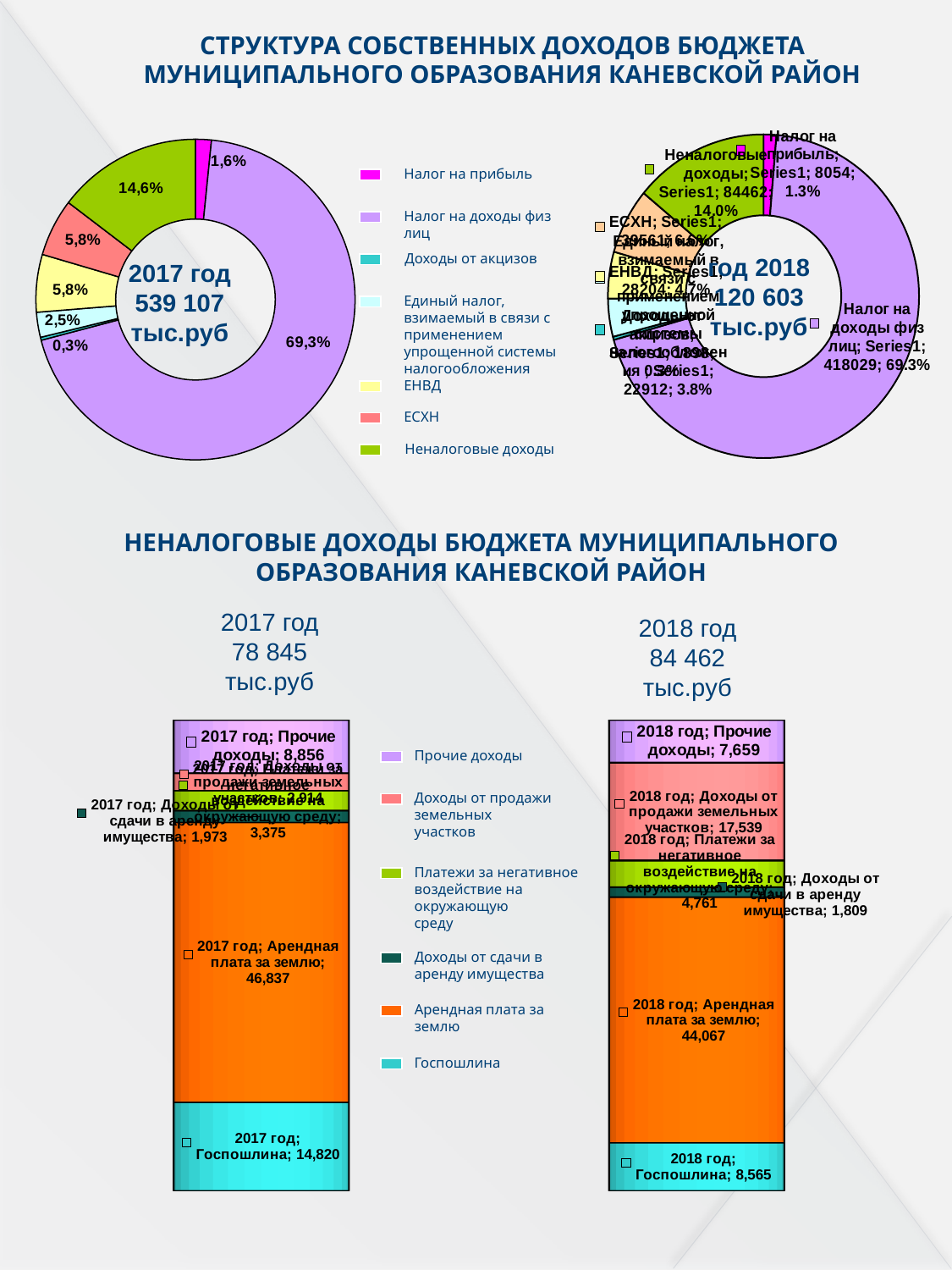
Comparing the bottom bar charts, is Госпошлина larger in 2017 or in 2018? 2017 In the 2017 donut chart (top left), which category has the smallest share? Доходы от акцизов In the 2017 donut chart (top left), what share is shown for Налог на доходы физ лиц? 69,3% What kind of chart is used for the structure of own budget revenues at the top of the slide? Pie (donut) chart What total amount is printed in the centre of the 2017 donut chart (top left)? 539 107 тыс.руб In the 2017 donut chart (top left), what share is shown for Неналоговые доходы? 14,6% How many entries does the legend of the top donut charts list? 7 In the 2017 stacked bar chart (bottom left), what value is shown for Госпошлина? 14,820 In the 2018 stacked bar chart (bottom right), which segment is the largest? Арендная плата за землю Comparing the bottom bar charts, by how much does Арендная плата за землю in 2017 exceed that in 2018? 2,770 In the 2018 stacked bar chart (bottom right), what value is shown for Доходы от продажи земельных участков? 17,539 In the 2017 stacked bar chart (bottom left), what value is shown for Арендная плата за землю? 46,837